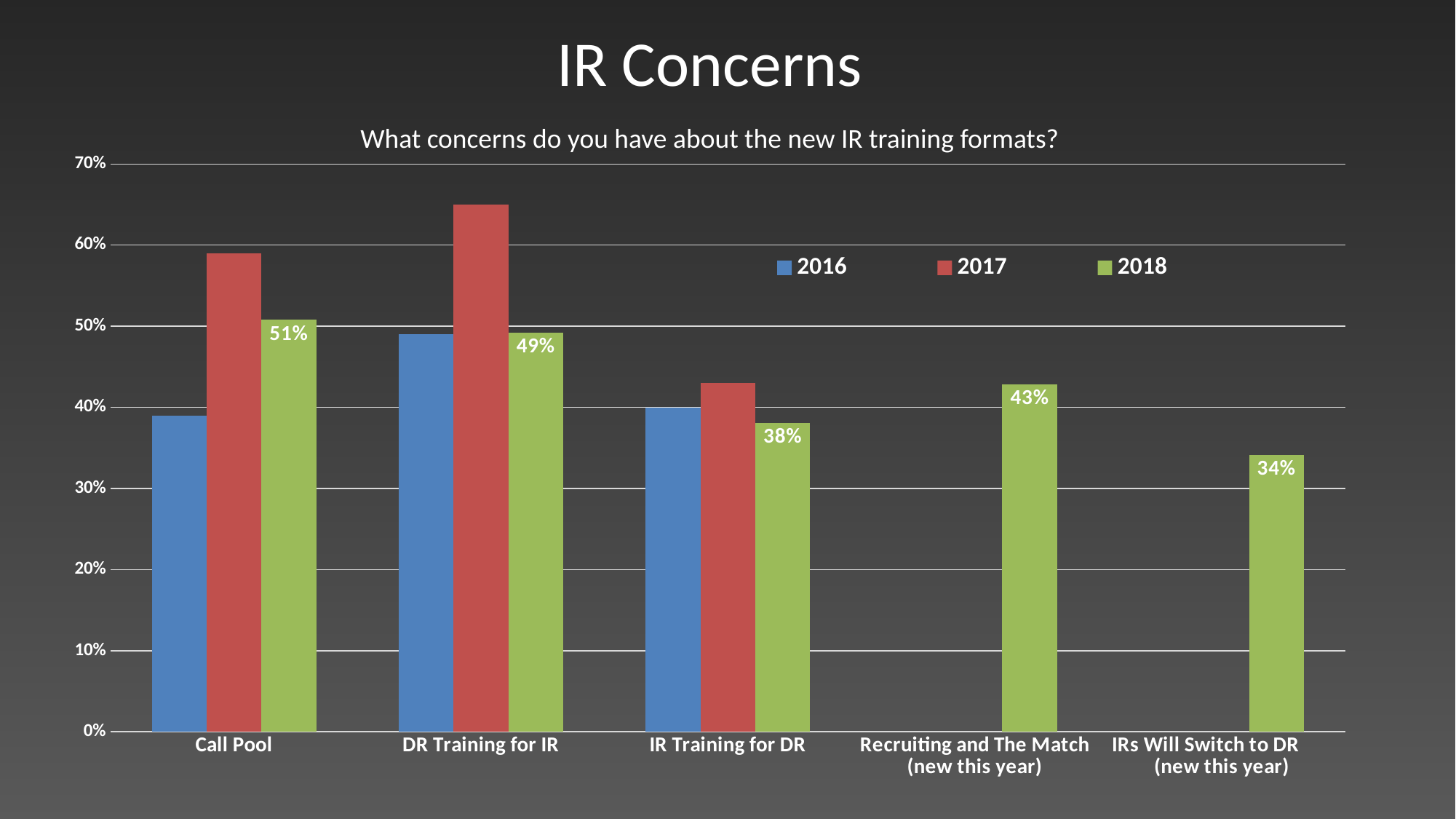
Which category has the highest 2018 value? Call Pool What is the 2018 value for Call Pool? 51% Is the 2017 value for DR Training for IR greater or less than 60%? greater What kind of chart is shown on the slide? Bar chart Which is larger: the 2018 value for Recruiting and The Match or the 2018 value for IR Training for DR? Recruiting and The Match Which category has the lowest 2018 value? IRs Will Switch to DR (new this year) How many series does the legend list? 3 Is the 2016 value for Call Pool greater or less than 40%? less What is the 2018 value for Recruiting and The Match (new this year)? 43% How many categories are shown on the x axis? 5 What is the 2018 value for IRs Will Switch to DR (new this year)? 34% What is the difference between the 2018 values for Call Pool and IR Training for DR? 13%